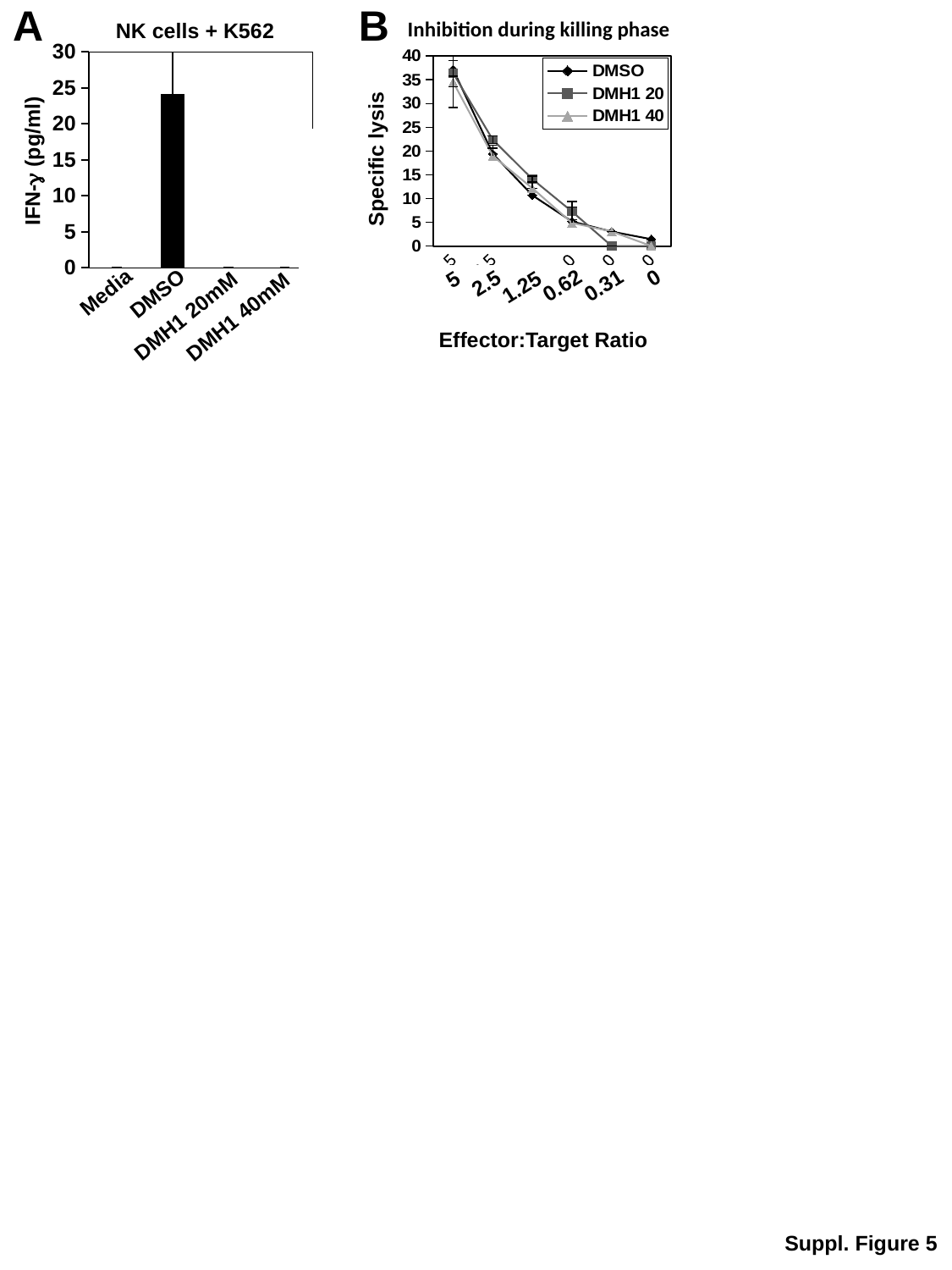
What is the y-axis title of the chart titled "NK cells + K562"? IFN-γ (pg/ml) In the chart titled "NK cells + K562", is the value for DMSO greater or less than 20? greater In the chart titled "NK cells + K562", is the value for DMSO greater or less than 30? less How many categories are shown on the x axis of the chart titled "NK cells + K562"? 4 How many series does the legend of the chart titled "Inhibition during killing phase" list? 3 What kind of chart is the chart titled "NK cells + K562"? bar chart In the chart titled "NK cells + K562", which category has the highest IFN-γ value? DMSO In the chart titled "Inhibition during killing phase", do the specific lysis values rise or fall as the Effector:Target Ratio goes from 5 to 0 along the x axis? fall In the chart titled "NK cells + K562", which is larger, the value for DMSO or the value for Media? DMSO What kind of chart is the chart titled "Inhibition during killing phase"? line chart In the chart titled "Inhibition during killing phase", is the DMSO value at an Effector:Target Ratio of 5 greater or less than 30? greater How many Effector:Target Ratio points are shown on the x axis of the chart titled "Inhibition during killing phase"? 6